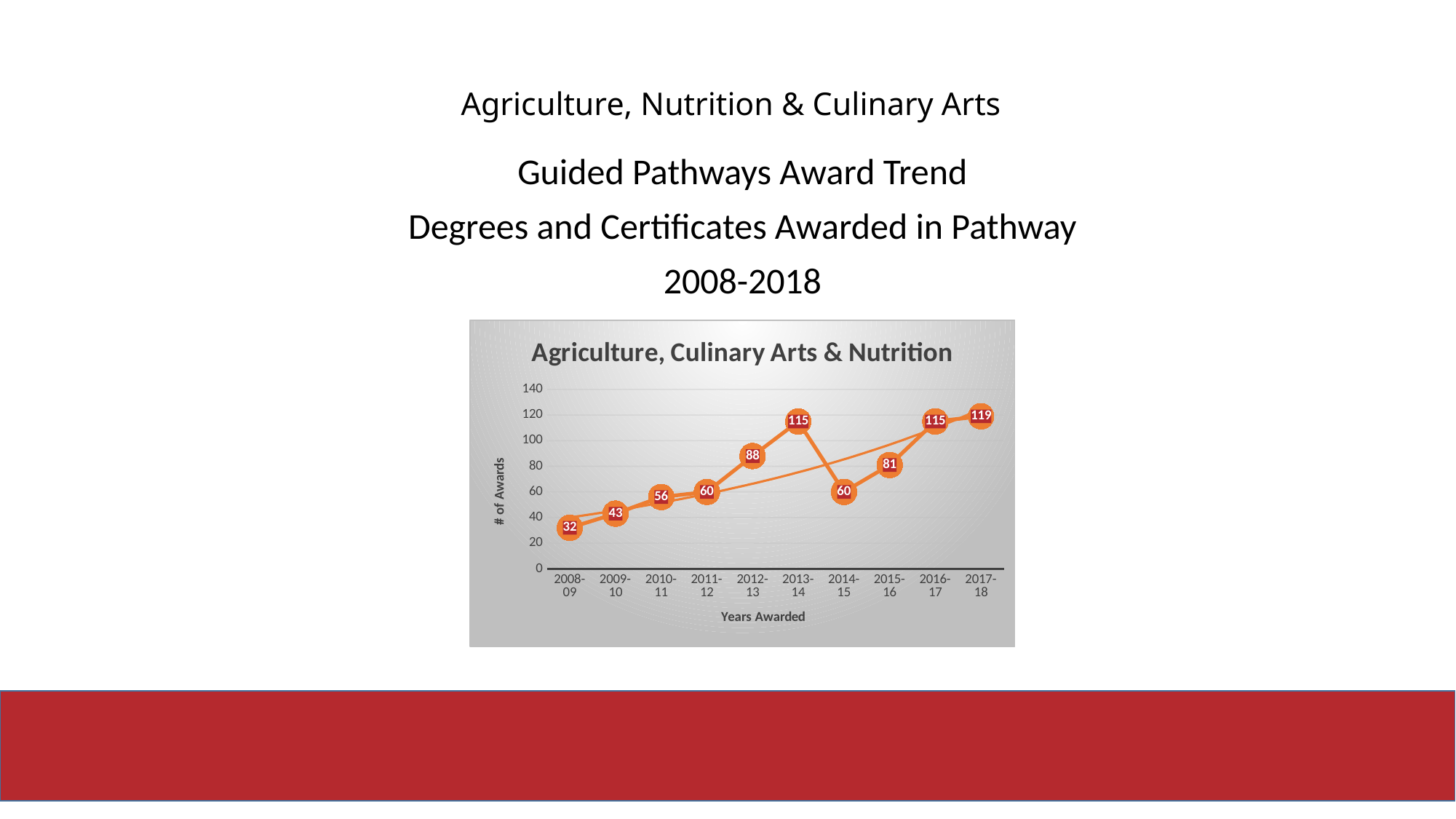
What kind of chart is shown? line chart Which is larger, the value for 2012-13 or the value for 2015-16? 2012-13 Is the value for 2016-17 greater or less than 100? greater What is the title of the chart? Agriculture, Culinary Arts & Nutrition Do the values generally rise or fall from 2008-09 to 2017-18? rise Which year has the lowest number of awards? 2008-09 How many years are plotted on the x axis? 10 What is the value for 2015-16? 81 What is the value for 2013-14? 115 What is the difference between the values for 2013-14 and 2014-15? 55 What is the value for 2008-09? 32 Which year has the highest number of awards? 2017-18